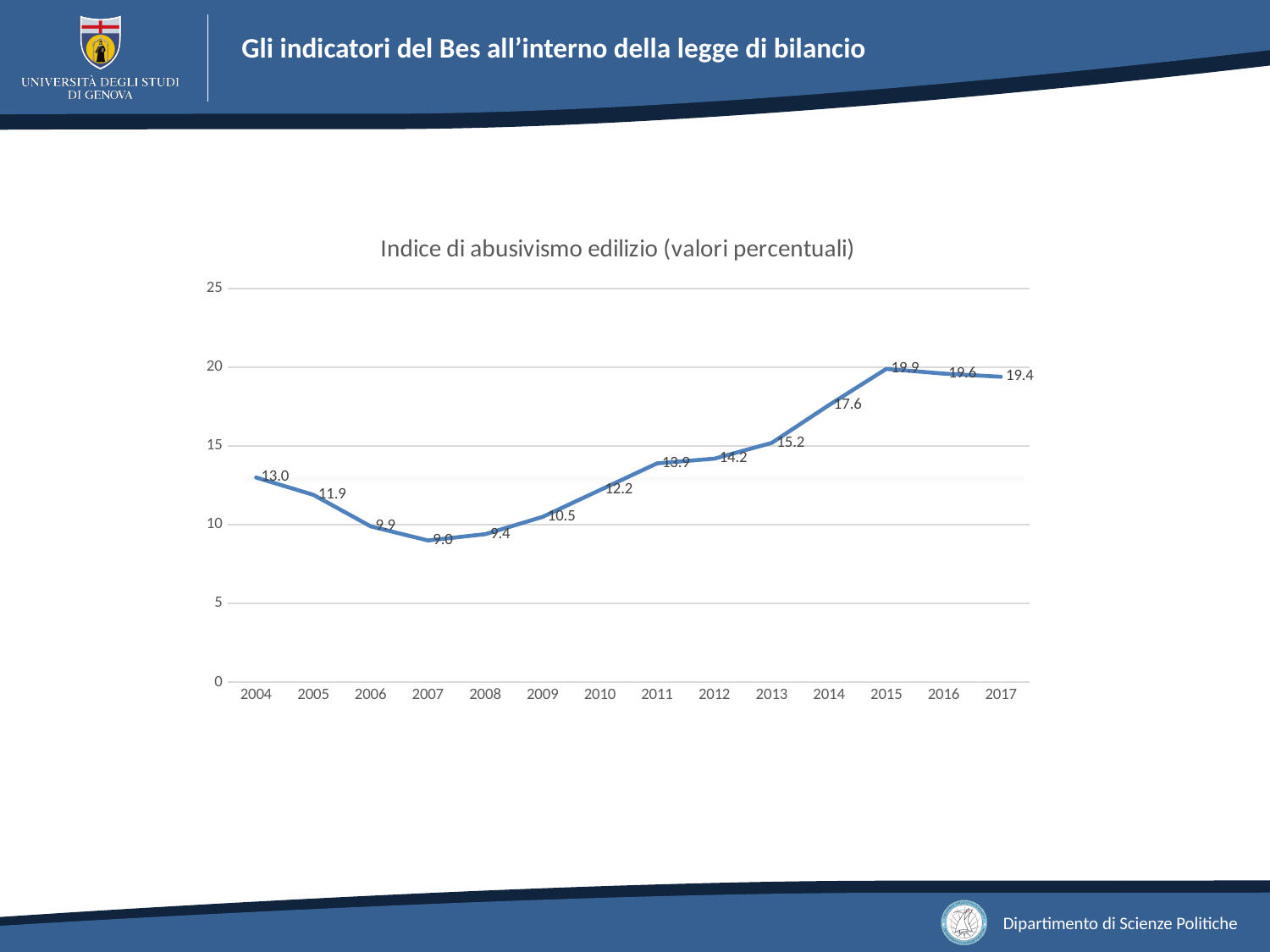
What is the value for 2017? 19.4 Which year has the lowest value? 2007 What is the value for 2010? 12.2 What is the value for 2004? 13.0 What is the title of the chart? Indice di abusivismo edilizio (valori percentuali) Which year has the highest value? 2015 Which is larger, the value for 2009 or the value for 2012? 2012 Is the value for 2014 greater or less than 15? greater What is the difference between the values for 2015 and 2004? 6.9 Do the values rise or fall from 2007 to 2015? rise What kind of chart is shown on the slide? line chart How many years are plotted on the x axis? 14